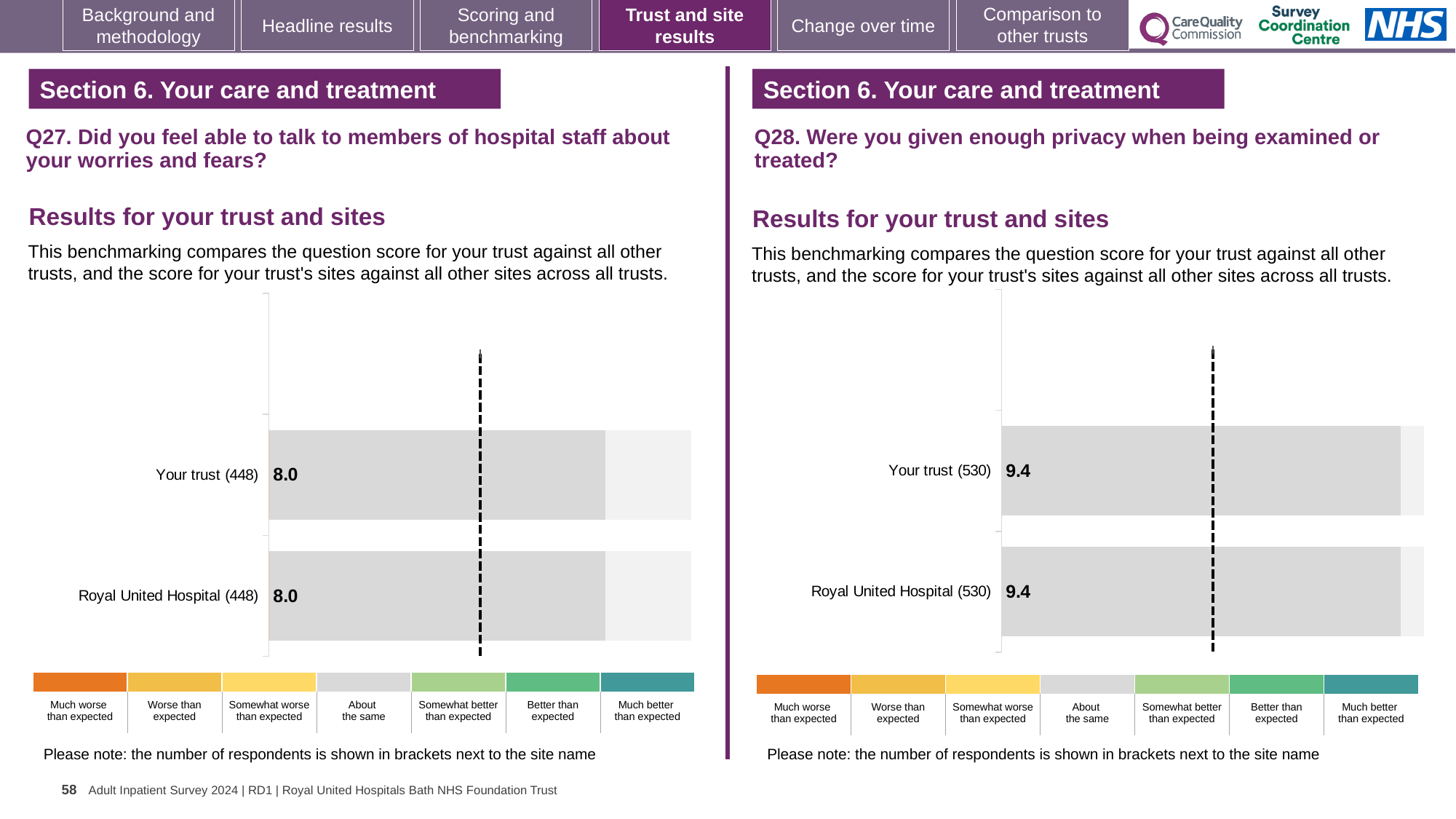
In the Q27 chart on the left, what is the score for Royal United Hospital? 8.0 In the Q27 chart on the left, what is the score for Your trust? 8.0 In the Q28 chart on the right, what is the score for Your trust? 9.4 In the Q27 chart on the left, how many respondents are shown in brackets next to Your trust? 448 How many bars are plotted in the Q27 chart on the left? 2 What kind of chart is used for the Q27 results on the left? Bar chart In the Q27 chart on the left, what is the difference between the score for Your trust and the score for Royal United Hospital? 0.0 In the Q28 chart on the right, what is the score for Royal United Hospital? 9.4 How many bars are plotted in the Q28 chart on the right? 2 In the Q28 chart on the right, what is the difference between the score for Your trust and the score for Royal United Hospital? 0.0 In the Q28 chart on the right, how many respondents are shown in brackets next to Royal United Hospital? 530